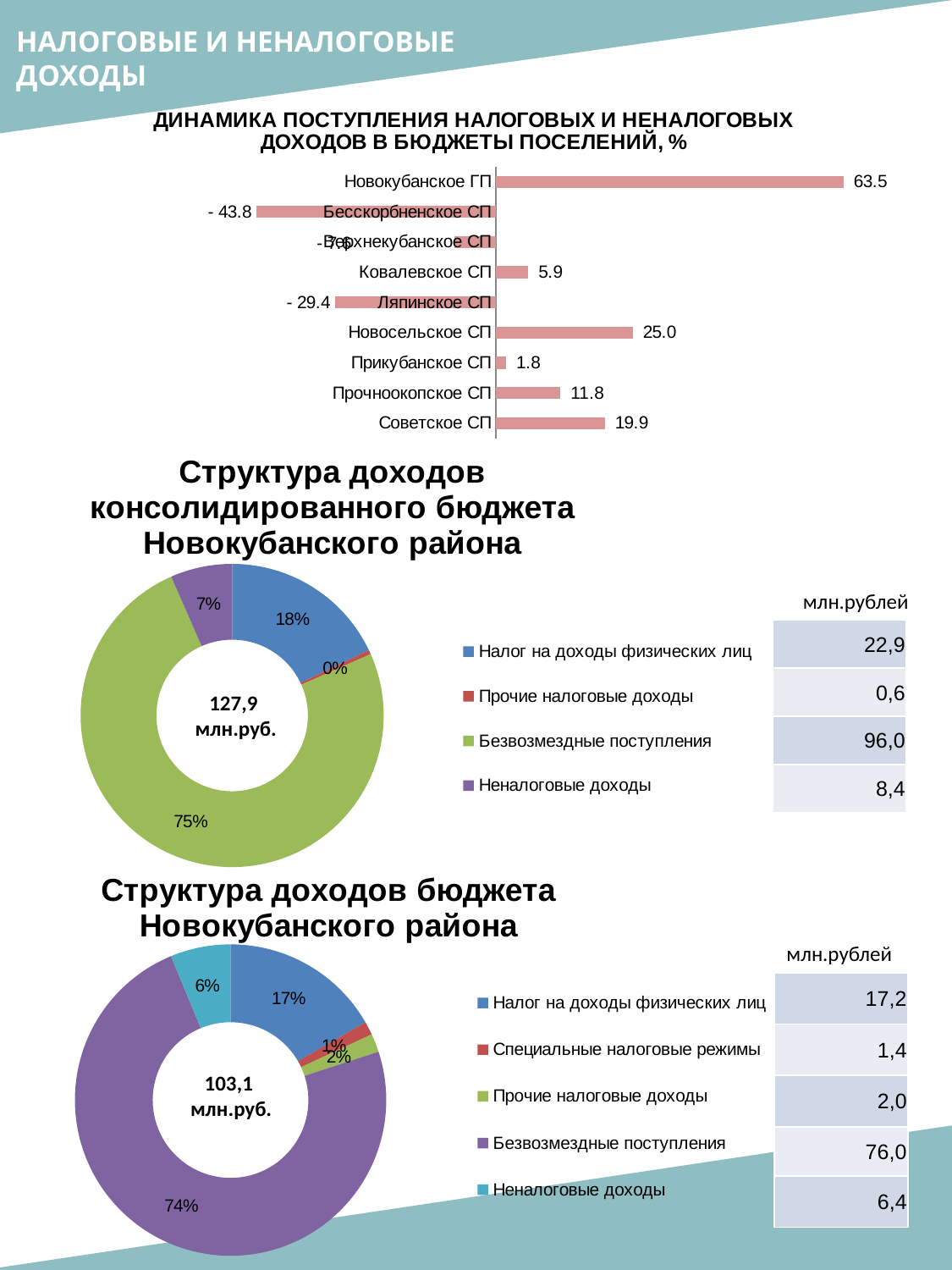
In the bar chart 'ДИНАМИКА ПОСТУПЛЕНИЯ НАЛОГОВЫХ И НЕНАЛОГОВЫХ ДОХОДОВ В БЮДЖЕТЫ ПОСЕЛЕНИЙ, %', which settlement has the lowest value? Бесскорбненское СП How many settlements are shown in the bar chart 'ДИНАМИКА ПОСТУПЛЕНИЯ НАЛОГОВЫХ И НЕНАЛОГОВЫХ ДОХОДОВ В БЮДЖЕТЫ ПОСЕЛЕНИЙ, %'? 9 In the bar chart 'ДИНАМИКА ПОСТУПЛЕНИЯ НАЛОГОВЫХ И НЕНАЛОГОВЫХ ДОХОДОВ В БЮДЖЕТЫ ПОСЕЛЕНИЙ, %', which settlement has the highest value? Новокубанское ГП In the bar chart 'ДИНАМИКА ПОСТУПЛЕНИЯ НАЛОГОВЫХ И НЕНАЛОГОВЫХ ДОХОДОВ В БЮДЖЕТЫ ПОСЕЛЕНИЙ, %', which is larger: the value for Прочноокопское СП or Ковалевское СП? Прочноокопское СП In the bar chart 'ДИНАМИКА ПОСТУПЛЕНИЯ НАЛОГОВЫХ И НЕНАЛОГОВЫХ ДОХОДОВ В БЮДЖЕТЫ ПОСЕЛЕНИЙ, %', what is the value for Новокубанское ГП? 63.5 In the chart 'Структура доходов консолидированного бюджета Новокубанского района', what share does Безвозмездные поступления have? 75% In the bar chart 'ДИНАМИКА ПОСТУПЛЕНИЯ НАЛОГОВЫХ И НЕНАЛОГОВЫХ ДОХОДОВ В БЮДЖЕТЫ ПОСЕЛЕНИЙ, %', what is the difference between the values for Новосельское СП and Советское СП? 5.1 How many series does the legend list in the chart 'Структура доходов бюджета Новокубанского района'? 5 What type of chart is 'ДИНАМИКА ПОСТУПЛЕНИЯ НАЛОГОВЫХ И НЕНАЛОГОВЫХ ДОХОДОВ В БЮДЖЕТЫ ПОСЕЛЕНИЙ, %'? Bar chart In the chart 'Структура доходов консолидированного бюджета Новокубанского района', what is the value in млн.рублей for Налог на доходы физических лиц? 22,9 In the bar chart 'ДИНАМИКА ПОСТУПЛЕНИЯ НАЛОГОВЫХ И НЕНАЛОГОВЫХ ДОХОДОВ В БЮДЖЕТЫ ПОСЕЛЕНИЙ, %', what is the value for Бесскорбненское СП? - 43.8 In the chart 'Структура доходов бюджета Новокубанского района', what total is shown in the centre of the doughnut? 103,1 млн.руб.